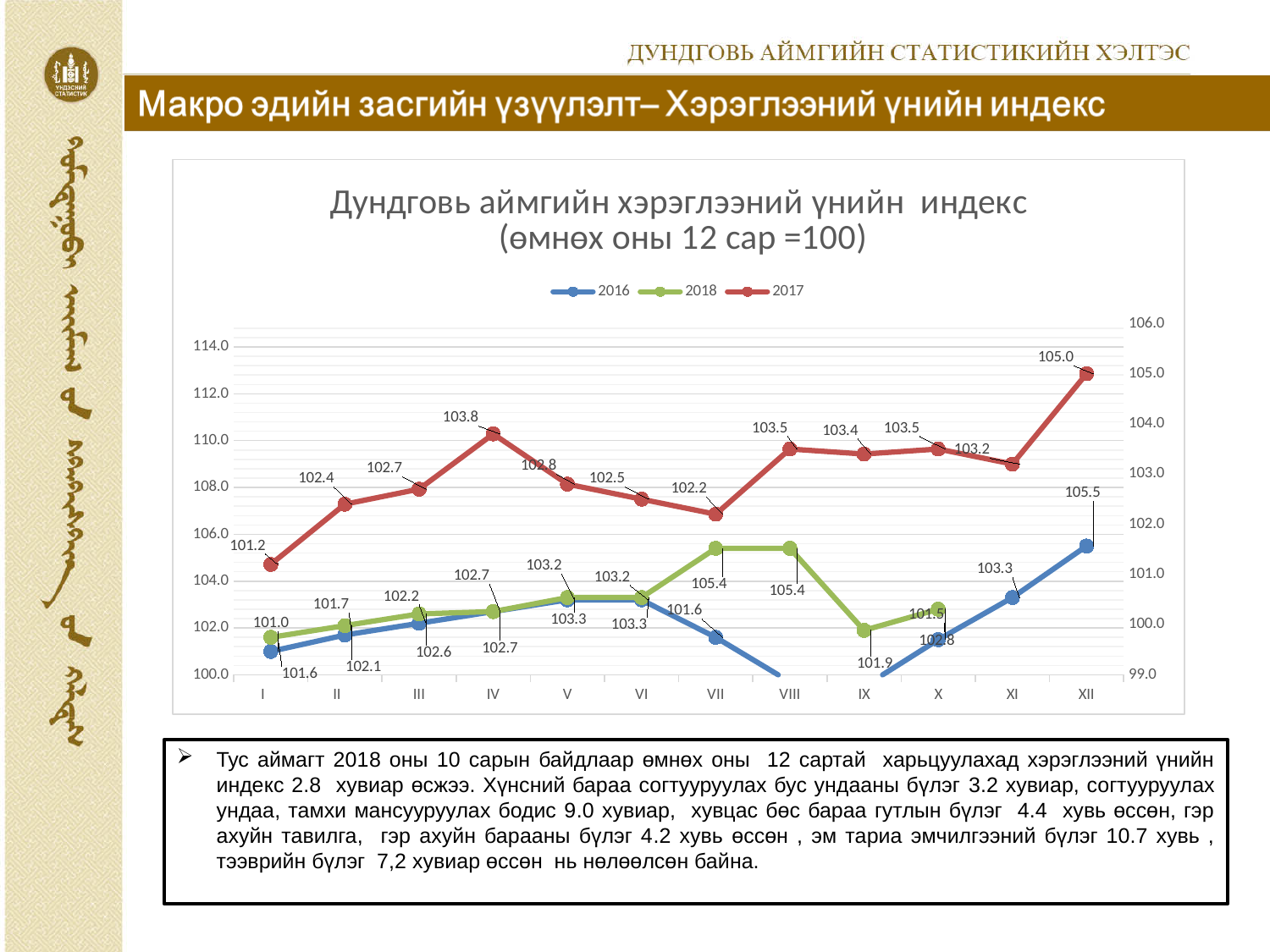
How many months (categories) are shown along the x axis? 12 How many series does the legend list? 3 What is the value of the 2017 series in month XII? 105.0 What is the value of the 2018 series in month VII? 105.4 For the 2017 series, which month has the larger value: IV or VII? IV In which month does the 2017 series reach its highest value? XII What is the difference between the 2017 values in month XII and month I? 3.8 What is the value of the 2017 series in month I? 101.2 What kind of chart is shown on the slide? line chart Does the 2017 series rise or fall from month I to month IV? rise What is the value of the 2017 series in month IV? 103.8 In which month does the 2017 series have its lowest value? I